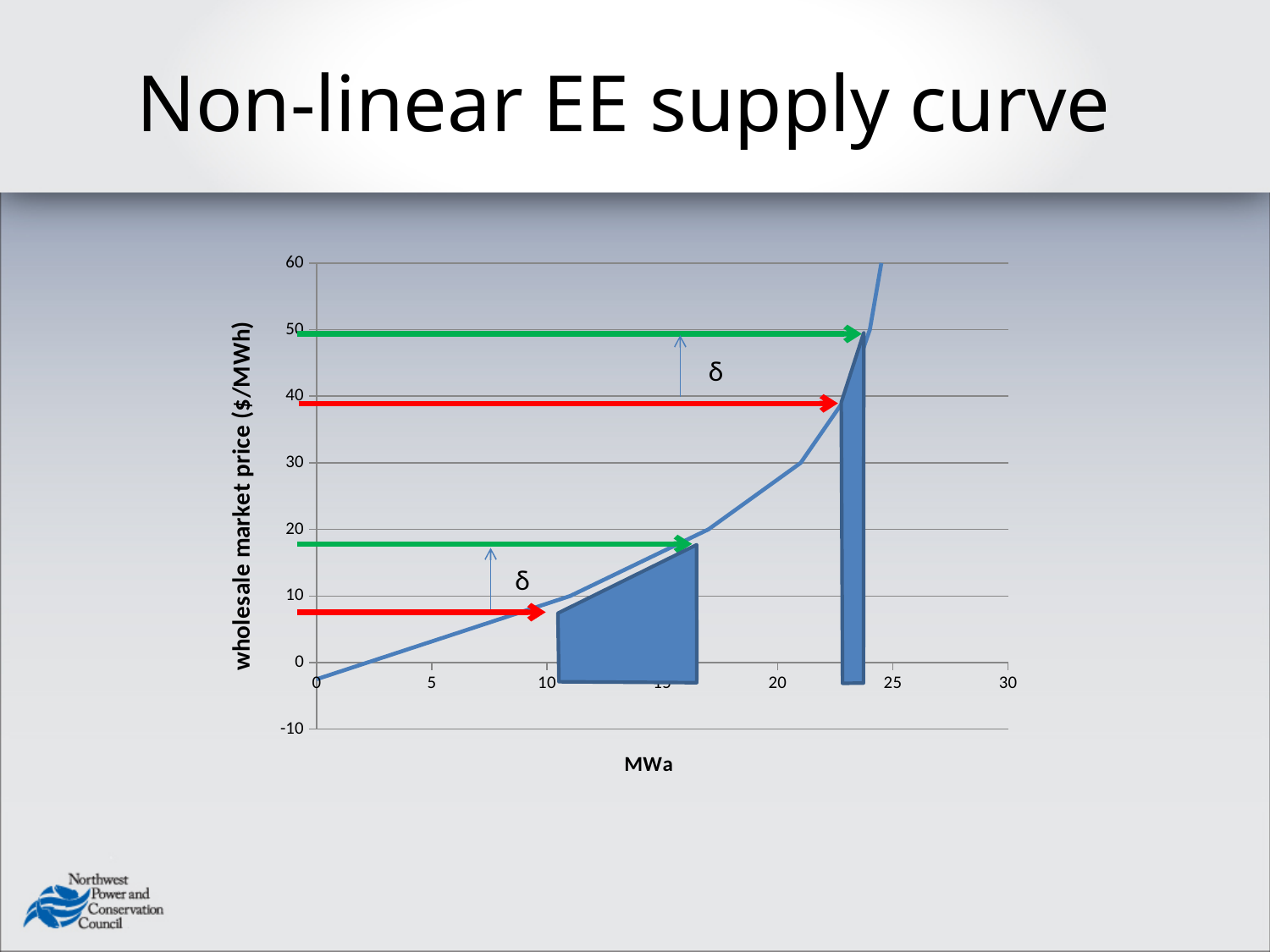
What is the label of the x axis? MWa Is the wholesale market price at 15 MWa greater or less than 10? greater What kind of chart is shown on the slide? line chart Is the wholesale market price at 22 MWa greater or less than 30? greater What is the highest value shown on the y axis? 60 Which is higher on the curve: the price at 10 MWa or the price at 20 MWa? 20 MWa Is the wholesale market price at 5 MWa greater or less than 10? less Does the supply curve rise or fall as MWa increases along the x axis? rise What is the lowest value shown on the y axis? -10